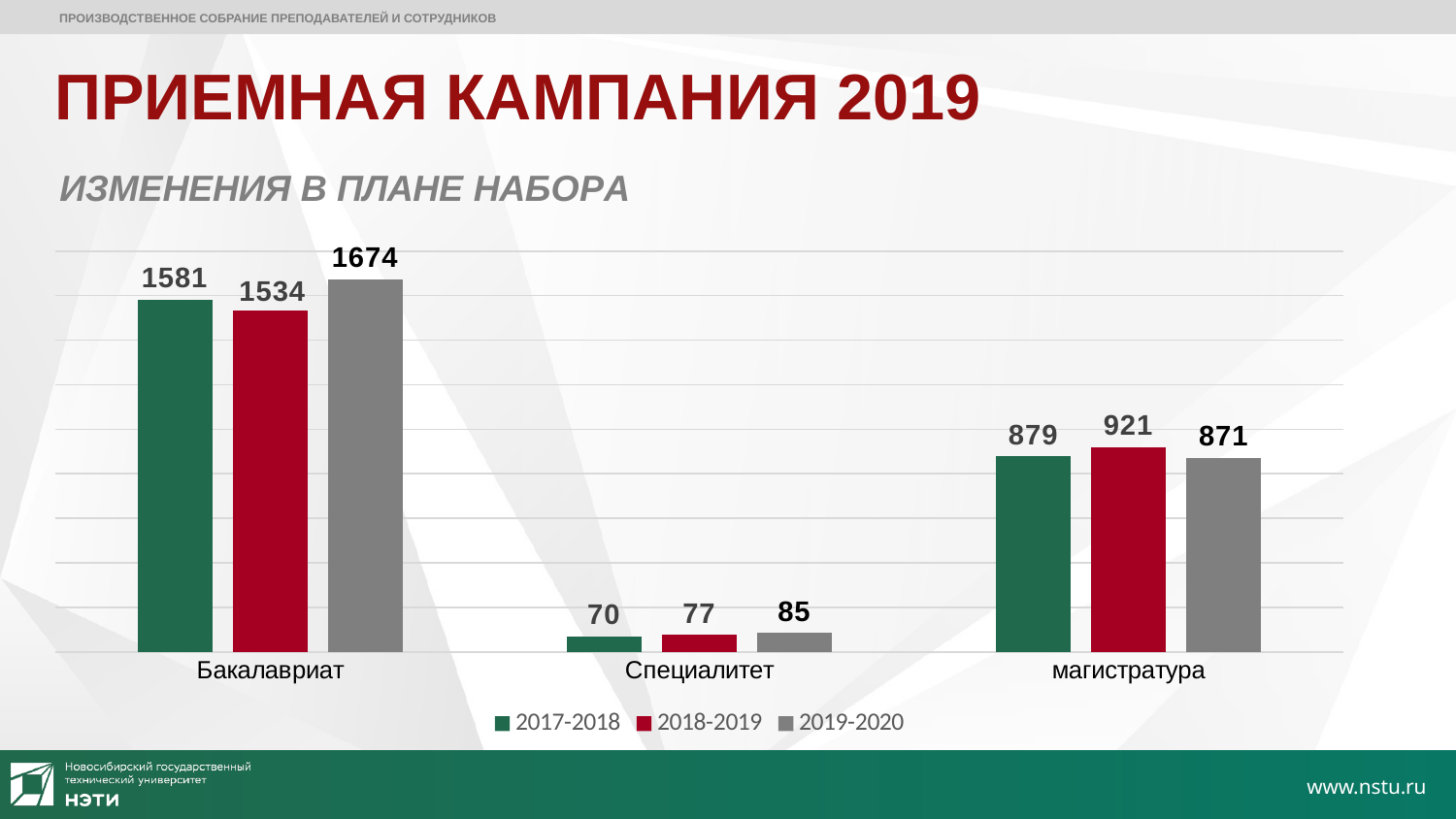
What is the value for Бакалавриат in the 2019-2020 series? 1674 What is the value for магистратура in the 2018-2019 series? 921 What is the difference between the 2019-2020 and 2018-2019 values for Бакалавриат? 140 What kind of chart is shown on the slide? bar chart How many series does the legend list? 3 What is the value for Специалитет in the 2017-2018 series? 70 How many categories are shown on the x axis? 3 Which category has the highest value in the 2017-2018 series? Бакалавриат What is the difference between the 2018-2019 and 2017-2018 values for магистратура? 42 Do the values for Специалитет rise or fall from 2017-2018 to 2019-2020? rise Which is larger for магистратура: the 2017-2018 value or the 2019-2020 value? 2017-2018 Which category has the lowest value in the 2019-2020 series? Специалитет